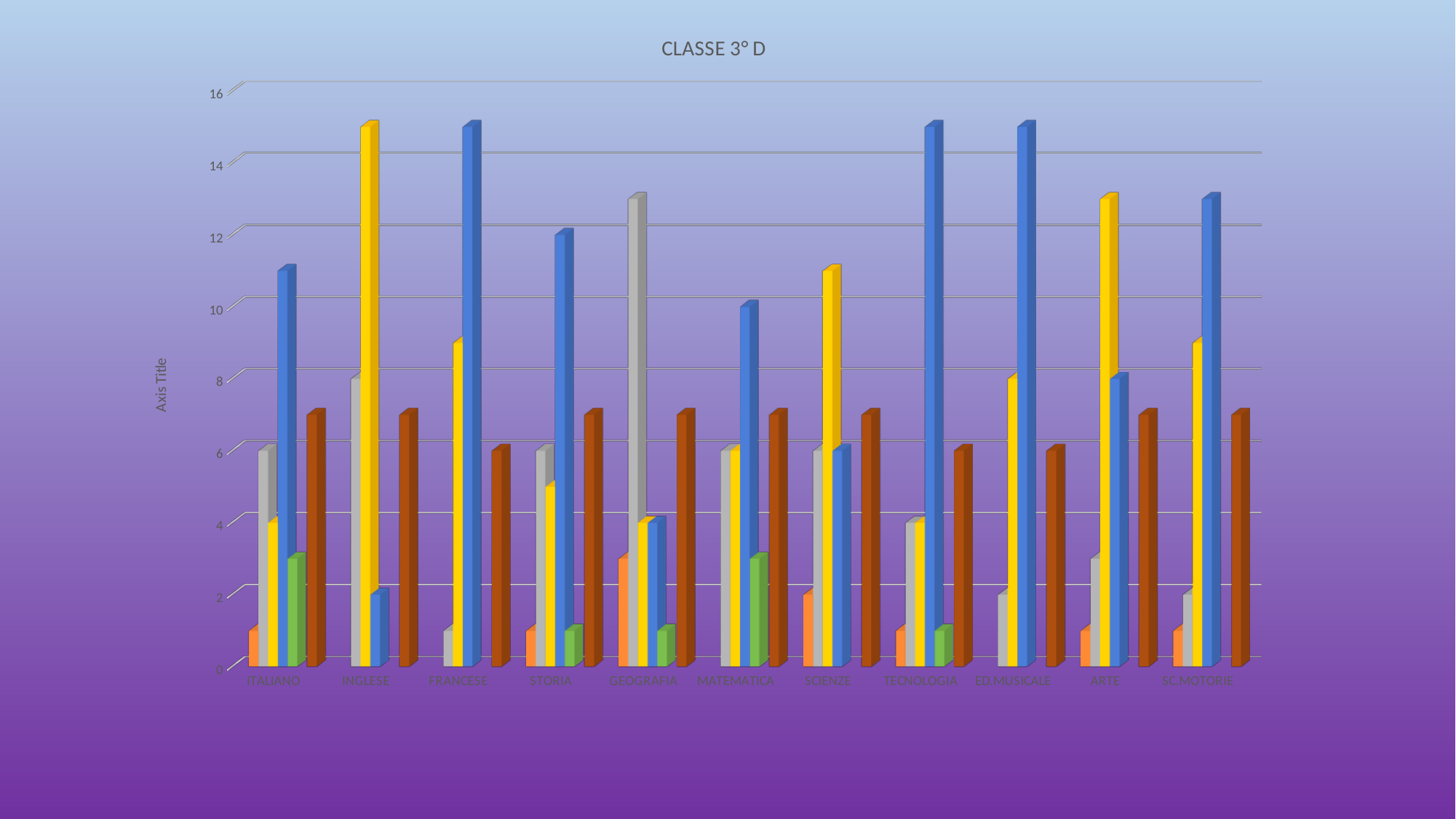
Is the value of the green bar for MATEMATICA greater or less than 4? less Is the value of the blue bar for FRANCESE greater or less than 14? greater How many categories are shown along the x axis of the chart? 11 Is the value of the yellow bar for INGLESE greater or less than 14? greater What is the title of the chart? CLASSE 3° D What is the label on the vertical axis of the chart? Axis Title Which category has the tallest yellow bar? INGLESE Which is larger, the yellow bar for INGLESE or the yellow bar for SCIENZE? INGLESE What kind of chart is shown on the slide? bar chart